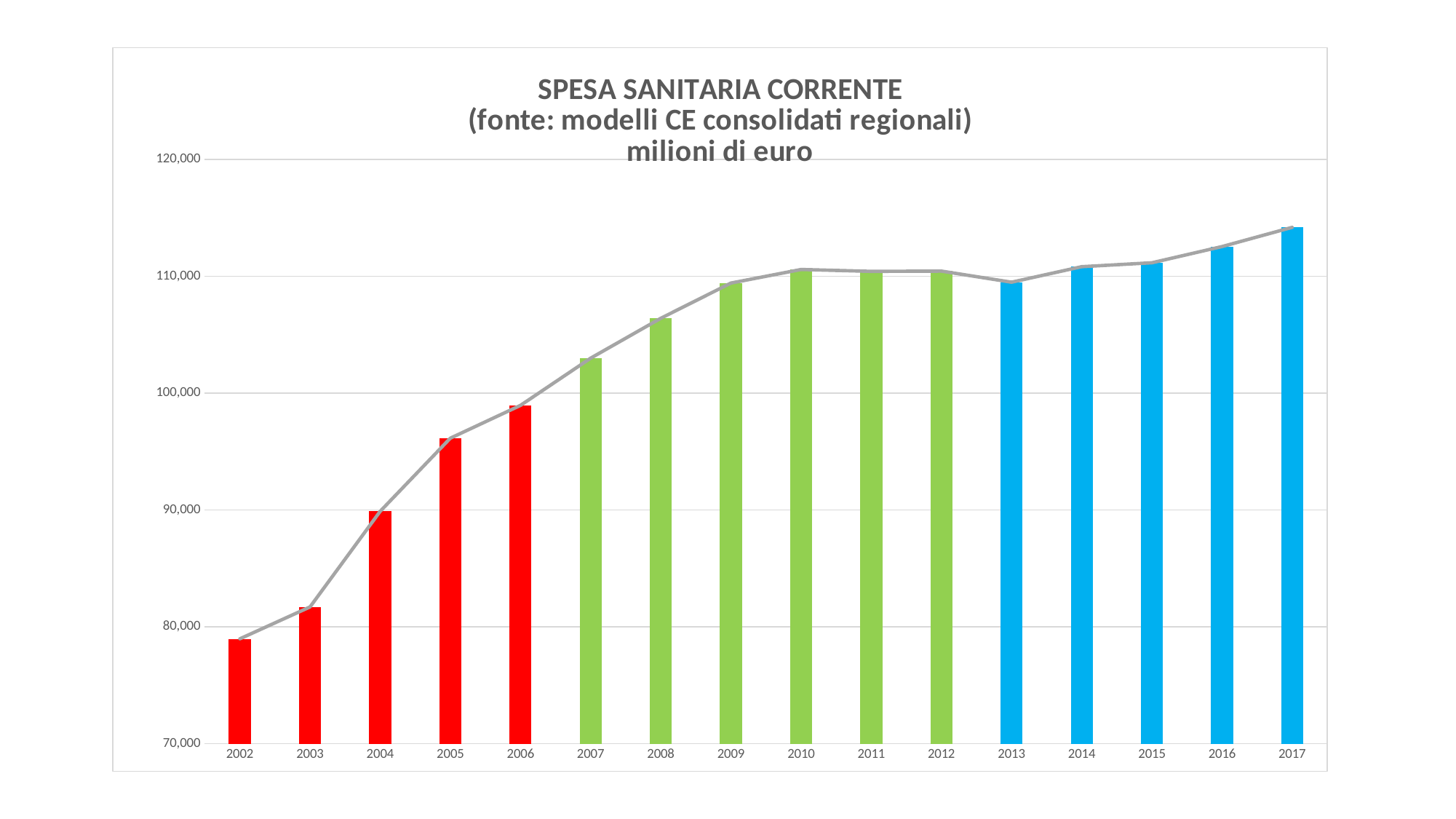
What colour are the bars for the years 2013 to 2017? Blue What kind of chart is shown on the slide? Combination bar and line chart Is the value for 2007 greater or less than 100,000? greater Which year has the lowest value in the chart? 2002 Which year has the highest value in the chart? 2017 Which is larger, the value for 2017 or the value for 2010? 2017 How many years are shown on the x axis of the chart? 16 Which is larger, the value for 2005 or the value for 2004? 2005 Is the value for 2002 greater or less than 80,000? less Is the value for 2006 greater or less than 100,000? less Do the values generally rise or fall from 2002 to 2017? Rise